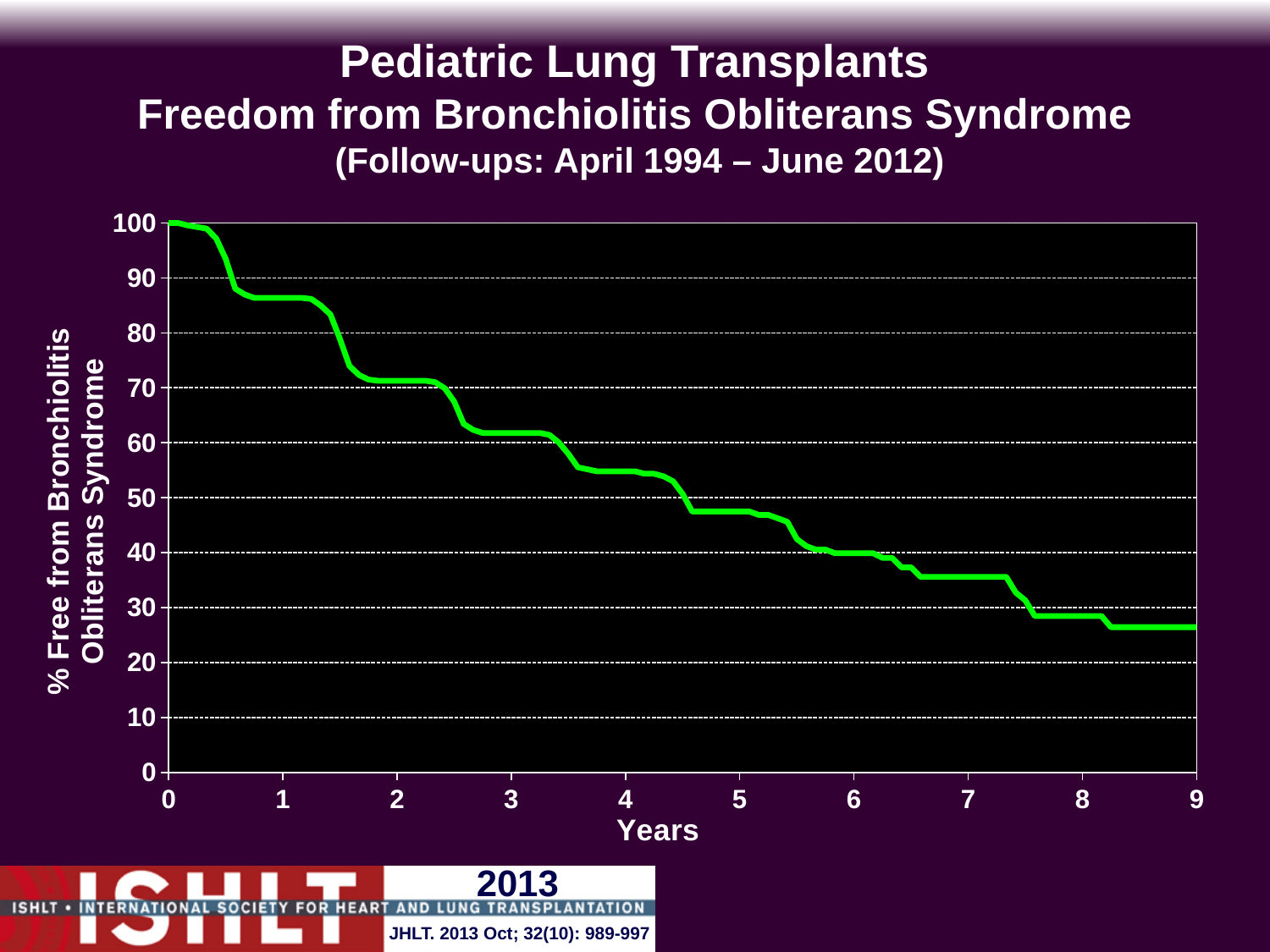
Is the value at year 6 greater or less than 50? less Do the values rise or fall as the years increase along the x axis? fall What kind of chart is shown on the slide? line chart What is the label of the x axis? Years Is the value at year 2 greater or less than 80? less Is the value at year 1 greater or less than 80? greater What is the label of the y axis? % Free from Bronchiolitis Obliterans Syndrome At which year is the % free from bronchiolitis obliterans syndrome highest? 0 What is the % free from bronchiolitis obliterans syndrome at year 0? 100